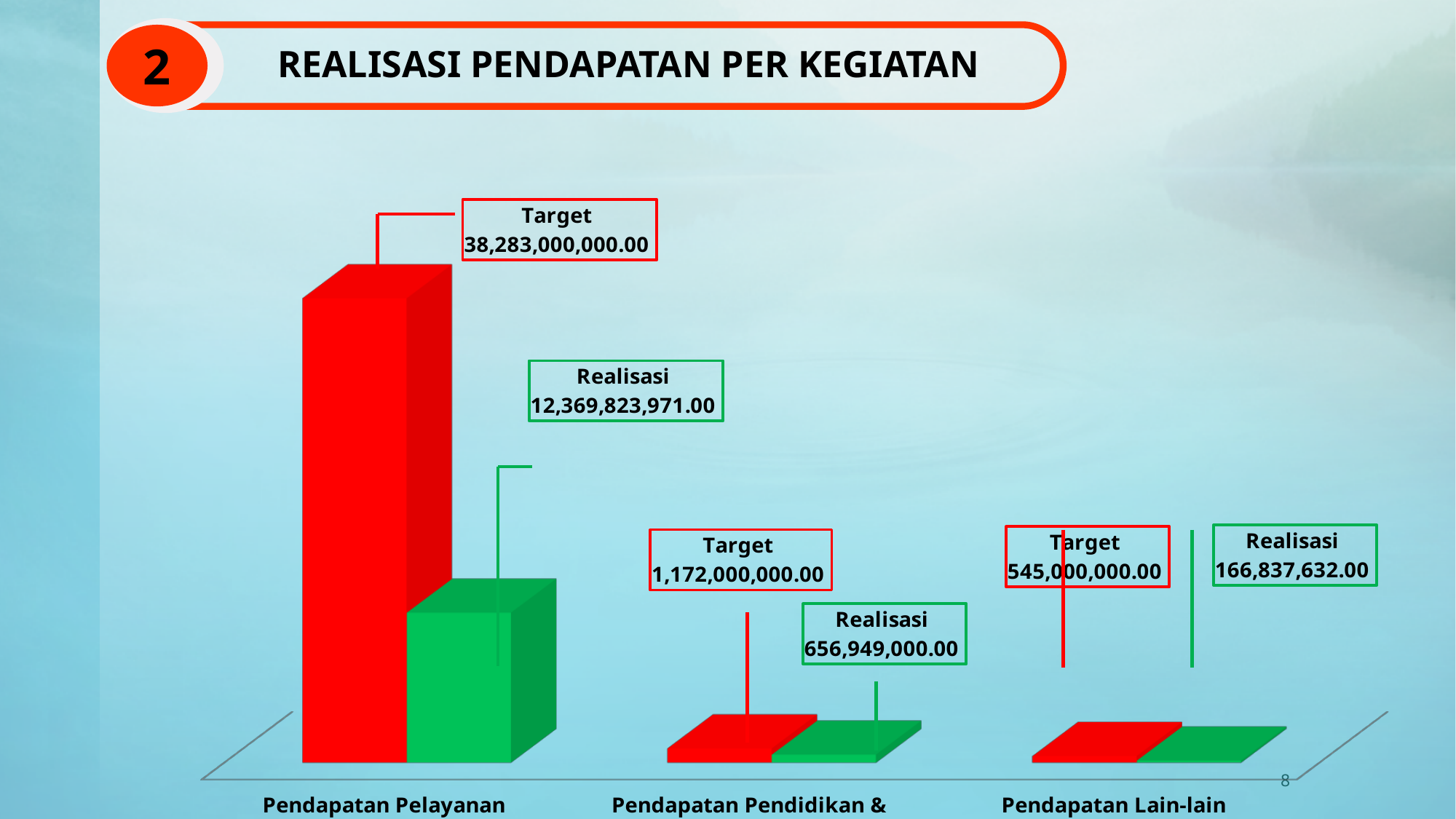
What is the Realisasi value for Pendapatan Pelayanan? 12,369,823,971.00 What is the Target value for the middle category, Pendapatan Pendidikan? 1,172,000,000.00 What is the difference between Target and Realisasi for Pendapatan Lain-lain? 378,162,368.00 What is the Target value for Pendapatan Pelayanan? 38,283,000,000.00 What type of chart is shown on the slide? Bar chart What is the difference between Target and Realisasi for Pendapatan Pelayanan? 25,913,176,029.00 Which category has the lowest Realisasi value? Pendapatan Lain-lain Which is larger for Pendapatan Pendidikan: the Target or the Realisasi? Target Which category has the highest Target value? Pendapatan Pelayanan How many categories are shown on the x axis? 3 What is the Realisasi value for Pendapatan Lain-lain? 166,837,632.00 How many series (Target and Realisasi) are plotted for each category? 2